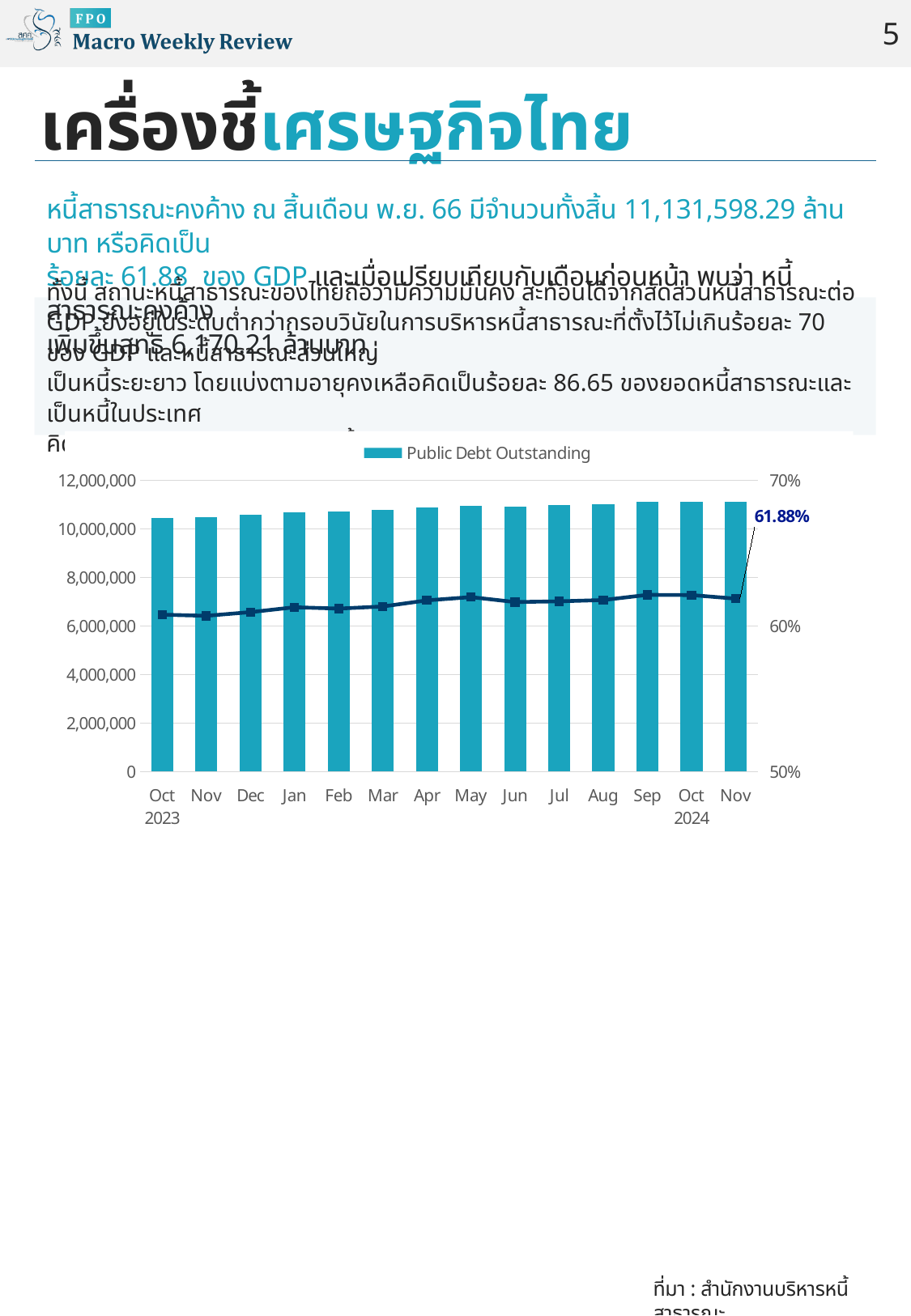
Which has a larger Public Debt Outstanding bar, Oct 2023 or Nov 2024? Nov 2024 Is the Public Debt Outstanding bar for Oct 2023 greater or less than 10,000,000? greater What is the first month shown on the x axis of the chart? Oct 2023 How many series does the chart legend list? 1 Is the line value for Oct 2023 greater or less than 60%? greater How many months (bars) are plotted on the chart? 14 What is the series name shown in the chart legend? Public Debt Outstanding Do the Public Debt Outstanding bars generally rise or fall from Oct 2023 to Nov 2024? Rise Is the Public Debt Outstanding bar for Nov 2024 greater or less than 12,000,000? less What value is labelled on the line for Nov 2024? 61.88% What kind of chart is shown on the slide? A bar chart combined with a line What is the highest tick shown on the right-hand percentage axis? 70%